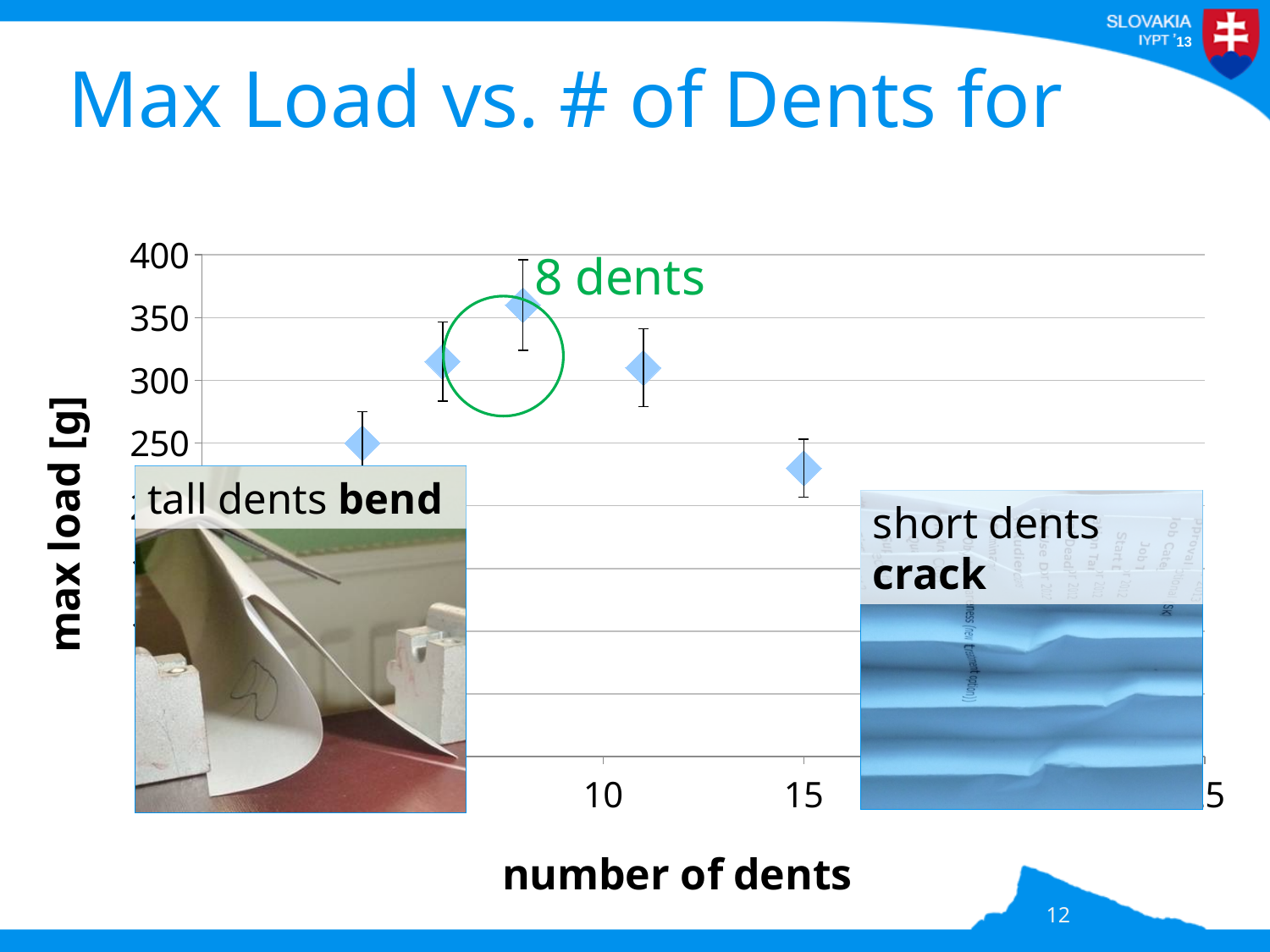
Is the max load for 4 dents greater or less than 300 g? less Is the max load for 6 dents greater or less than 300 g? greater Which has a larger max load, 6 dents or 4 dents? 6 dents How does the max load change as the number of dents increases along the x axis? rises then falls What is the label of the y axis? max load [g] Is the max load for 8 dents greater or less than 300 g? greater At which number of dents is the max load highest? 8 dents What kind of chart is shown on the slide? scatter chart Which has a larger max load, 8 dents or 15 dents? 8 dents